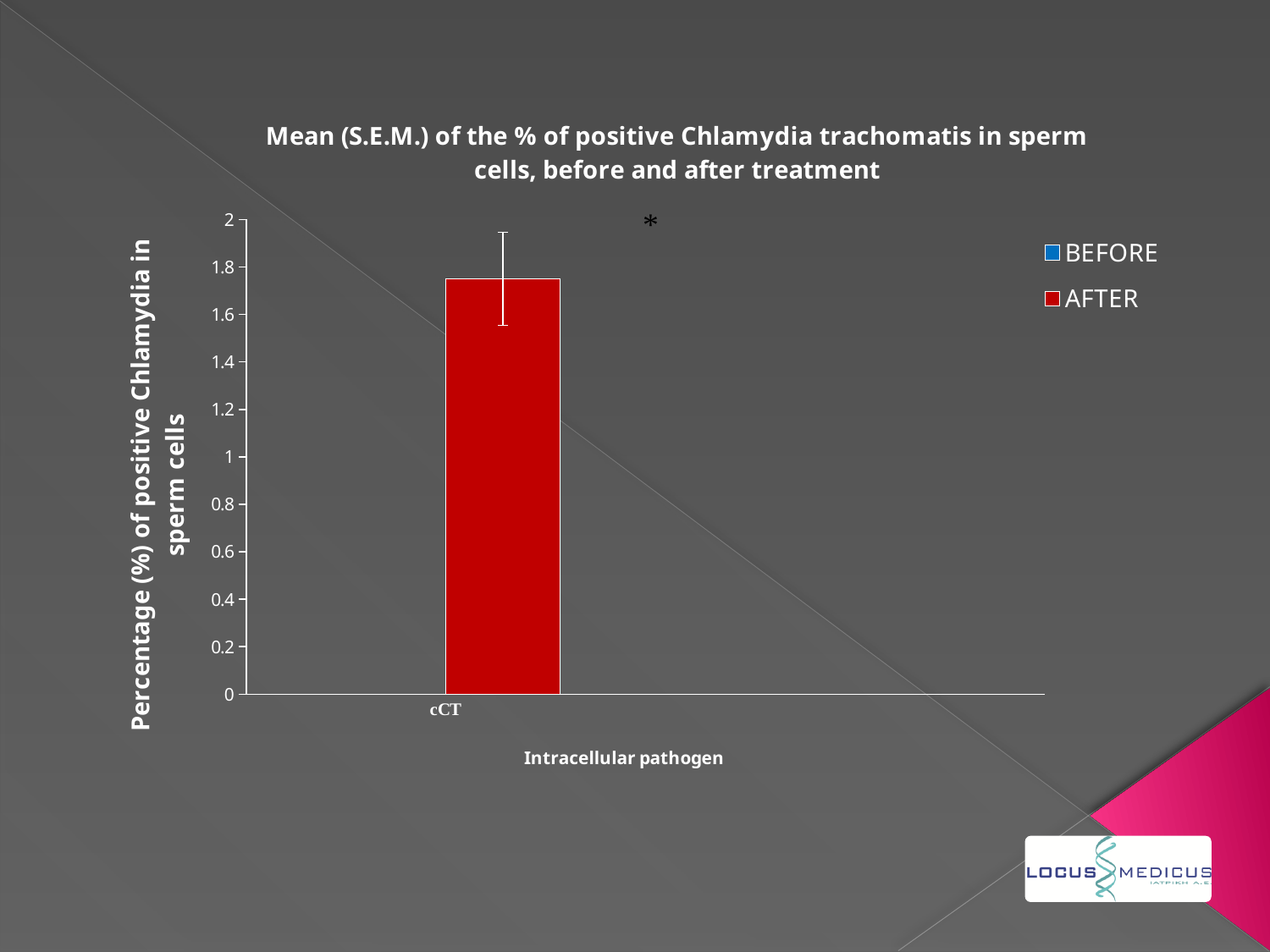
How many series does the legend list? 2 What is the title of the chart? Mean (S.E.M.) of the % of positive Chlamydia trachomatis in sperm cells, before and after treatment Is the AFTER value for cCT greater or less than 2? less How many categories are shown on the x axis? 1 What kind of chart is shown on the slide? bar chart What is the label of the single category on the x axis? cCT What colour is the AFTER series in the legend? red Is the AFTER value for cCT greater or less than 1? greater Is the AFTER value for cCT greater or less than 1.6? greater